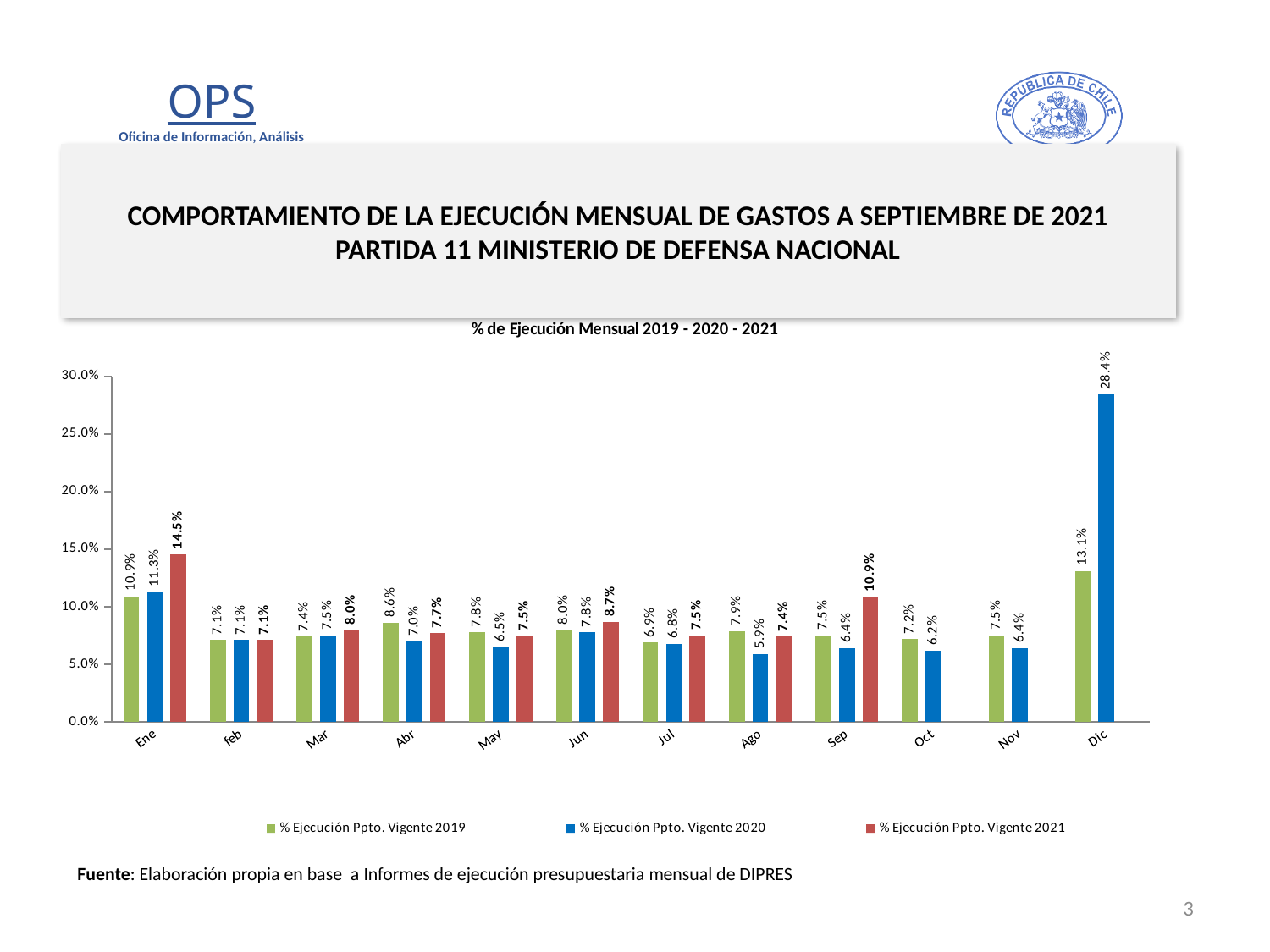
What is the title of the chart? % de Ejecución Mensual 2019 - 2020 - 2021 What is the value for % Ejecución Ppto. Vigente 2019 in Ene? 10.9% What is the value for % Ejecución Ppto. Vigente 2020 in Dic? 28.4% What is the difference between the 2020 and 2019 values in Dic? 15.3 percentage points In Abr, which series has the larger value: % Ejecución Ppto. Vigente 2019 or % Ejecución Ppto. Vigente 2020? % Ejecución Ppto. Vigente 2019 What kind of chart is shown on the slide? Bar chart How many series does the legend list? 3 Which month has the highest value for % Ejecución Ppto. Vigente 2021? Ene How many months are shown on the x axis? 12 Which month has the lowest value for % Ejecución Ppto. Vigente 2020? Ago Is the value for % Ejecución Ppto. Vigente 2020 in Dic greater or less than 25.0%? greater What is the value for % Ejecución Ppto. Vigente 2021 in Sep? 10.9%